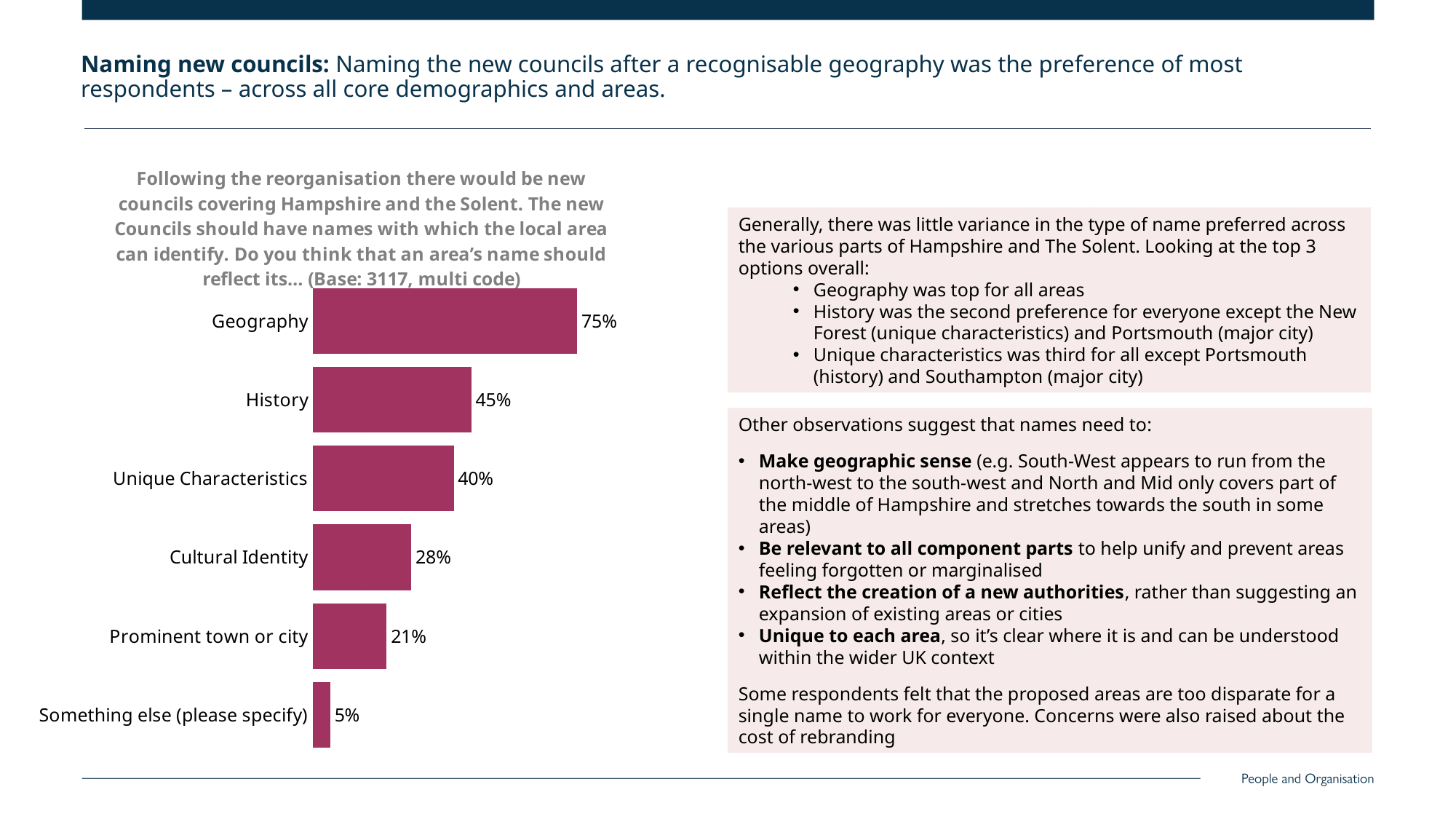
What percentage is shown for Cultural Identity? 28% What is the difference between the values for Geography and History? 30% What percentage of respondents chose Geography? 75% What is the difference between Unique Characteristics and Cultural Identity? 12% How many categories are shown in the chart? 6 Which category has the highest value? Geography What is the value shown for History? 45% What type of chart is shown on the slide? Bar chart Which is larger, the value for History or the value for Unique Characteristics? History Which category has the lowest value? Something else (please specify) What base size is stated in the chart title? 3117 What is the value for Prominent town or city? 21%